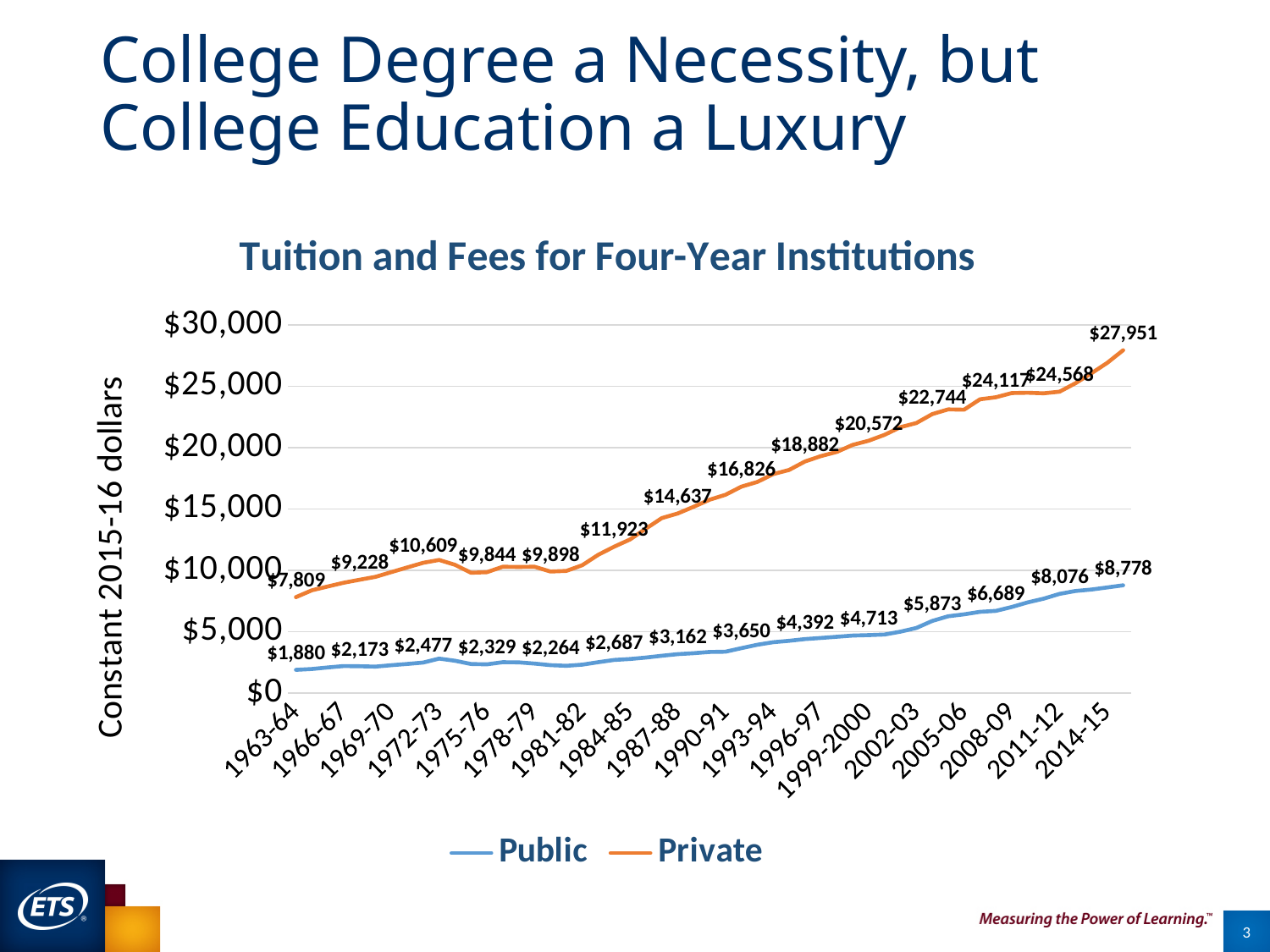
What kind of chart is shown on the slide? line chart Is the Public value at 2014-15 greater or less than $10,000? less What are the two series named in the legend? Public and Private Which series has higher values across the whole chart, Public or Private? Private What is the highest labeled value on the Private line? $27,951 What is the lowest labeled value on the Public line? $1,880 What is the first labeled value on the Public line? $1,880 What is the difference between the last labeled Private value ($27,951) and the last labeled Public value ($8,778)? $19,173 What is the last labeled value on the Private line? $27,951 What is the last labeled value on the Public line? $8,778 What is the first labeled value on the Private line? $7,809 How many series does the legend list? 2